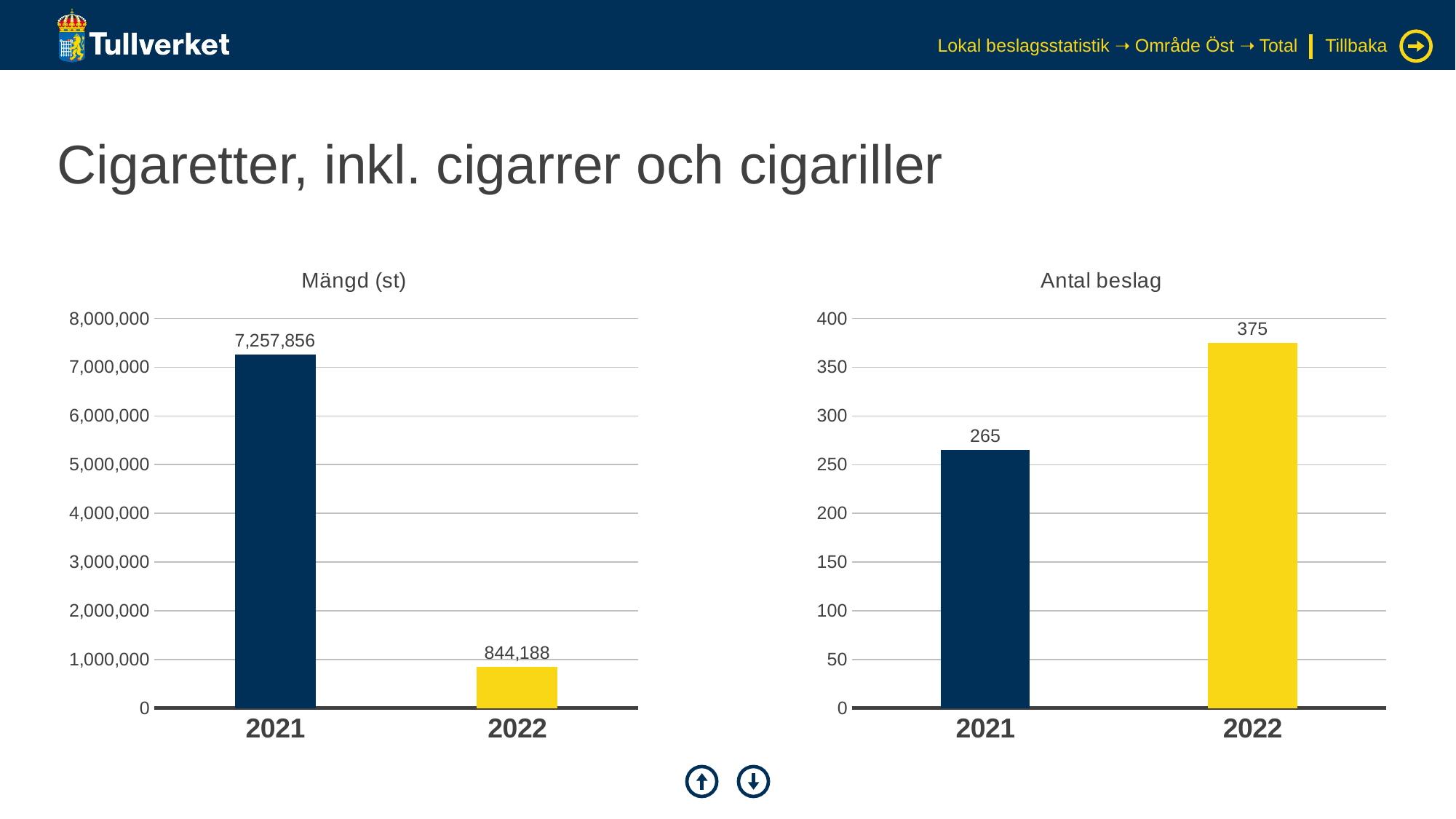
In the 'Mängd (st)' chart, what is the difference between the 2021 and 2022 values? 6,413,668 In the 'Mängd (st)' chart, which year has the highest value? 2021 In the 'Mängd (st)' chart, what is the value for 2022? 844,188 In the 'Antal beslag' chart, is the value for 2022 greater or less than 350? greater How many categories are shown in the 'Antal beslag' chart? 2 What kind of chart is the 'Mängd (st)' chart? bar chart In the 'Antal beslag' chart, what is the value for 2022? 375 In the 'Mängd (st)' chart, what is the value for 2021? 7,257,856 In the 'Antal beslag' chart, which year has the lowest value? 2021 In the 'Mängd (st)' chart, do the values rise or fall from 2021 to 2022? fall In the 'Antal beslag' chart, what is the value for 2021? 265 In the 'Antal beslag' chart, what is the difference between the 2022 and 2021 values? 110